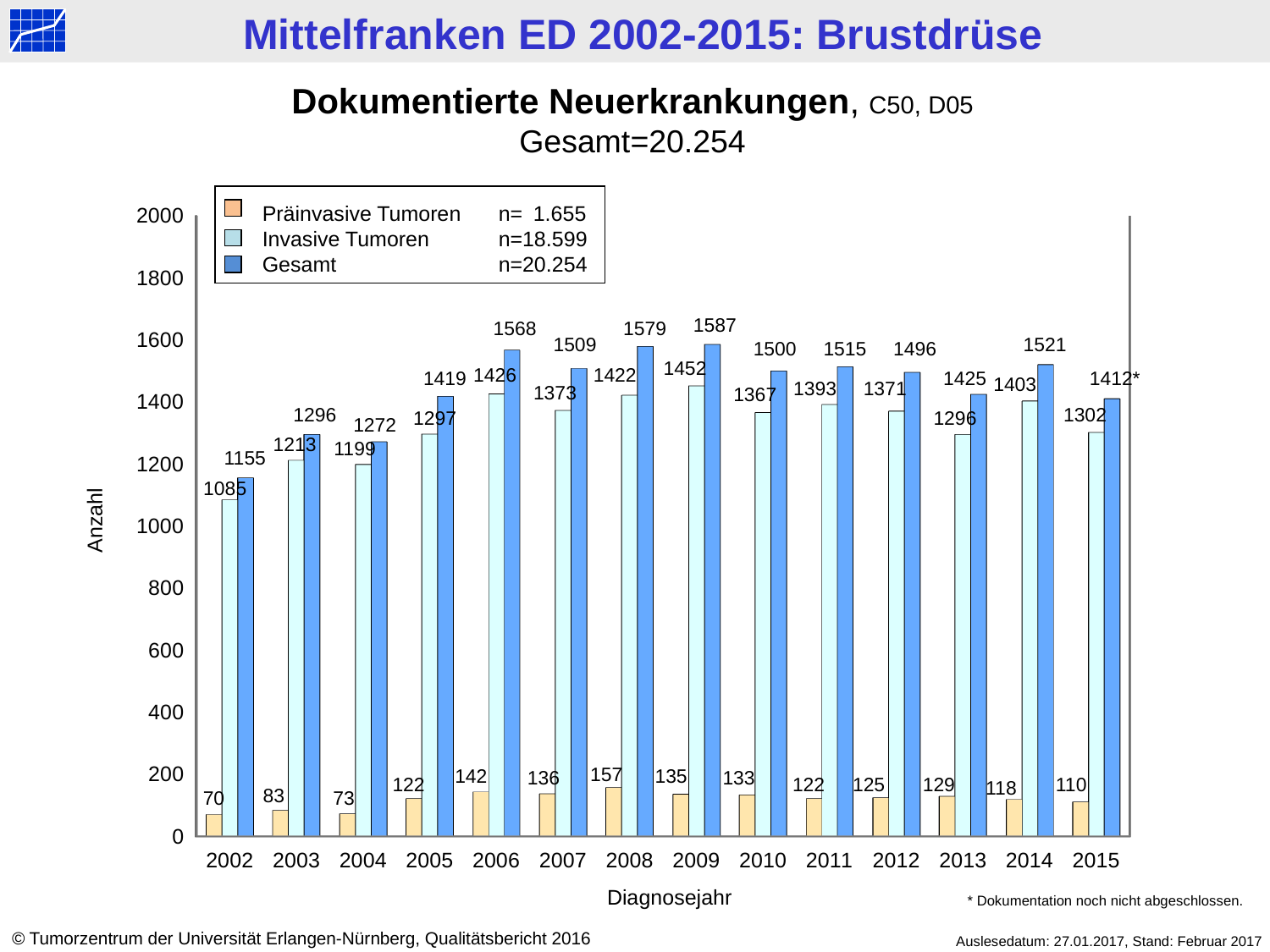
What is the value for Invasive Tumoren in 2006? 1426 Which year has the lowest value for Präinvasive Tumoren? 2002 What is the difference between the Gesamt values for 2009 and 2002? 432 What is the Gesamt value for 2009? 1587 What is the total n for Invasive Tumoren given in the legend? n=18.599 How many series does the legend list? 3 Which year has the highest Gesamt value? 2009 What is the value for Präinvasive Tumoren in 2008? 157 What kind of chart is shown on the slide? bar chart How many years are shown on the x axis? 14 Which is larger, the Invasive Tumoren value for 2010 or for 2011? 2011 Is the Gesamt value for 2005 greater or less than 1400? greater